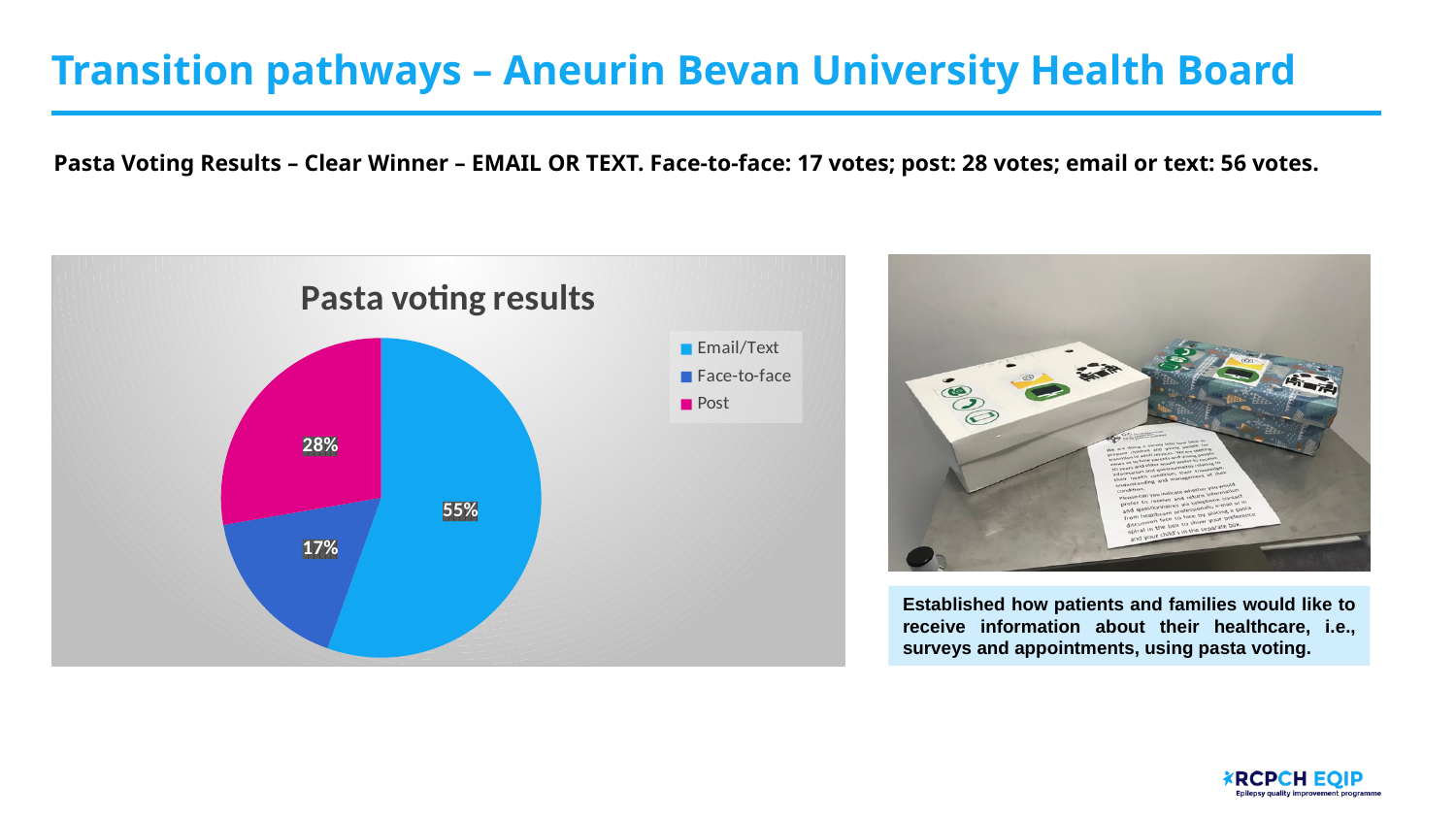
What kind of chart is shown on the slide? pie chart Which slice is larger, Post or Face-to-face? Post How many entries does the legend list? 3 Which category has the smallest slice of the pie? Face-to-face Which category has the largest slice of the pie? Email/Text What is the difference in percentage points between the Email/Text slice and the Post slice? 27 What is the title of the chart? Pasta voting results How many slices does the pie chart have? 3 What percentage share does the Email/Text slice have? 55% What percentage share does the Post slice have? 28% What percentage share does the Face-to-face slice have? 17% What colour is the Post slice in the pie chart? magenta/pink